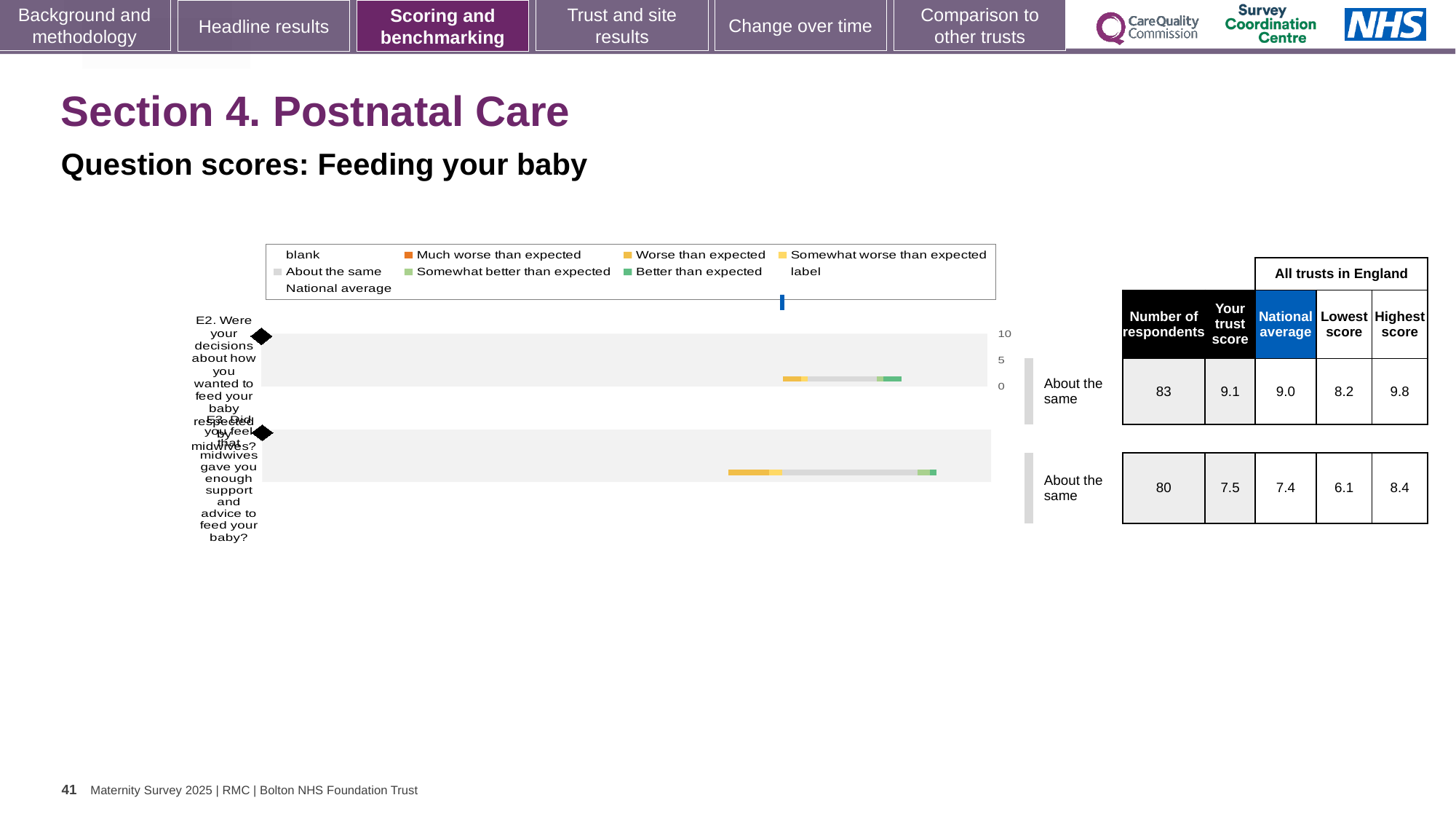
What benchmark category is shown for question E3? About the same Which question has the higher trust score, E2 or E3? E2 What is the national average for question E2? 9.0 What kind of chart is shown on the slide? bar chart What is the lowest score among all trusts in England for question E2? 8.2 Which question has more respondents, E2 or E3? E2 What is the subtitle describing the question scores on this slide? Question scores: Feeding your baby What is the difference between the highest and lowest scores for question E3? 2.3 What is the number of respondents for question E2 about decisions on how to feed your baby being respected by midwives? 83 How many questions (categories) are plotted in the chart? 2 What is the trust score for question E3 about midwives giving enough support and advice to feed your baby? 7.5 What is the highest score among all trusts in England for question E3? 8.4